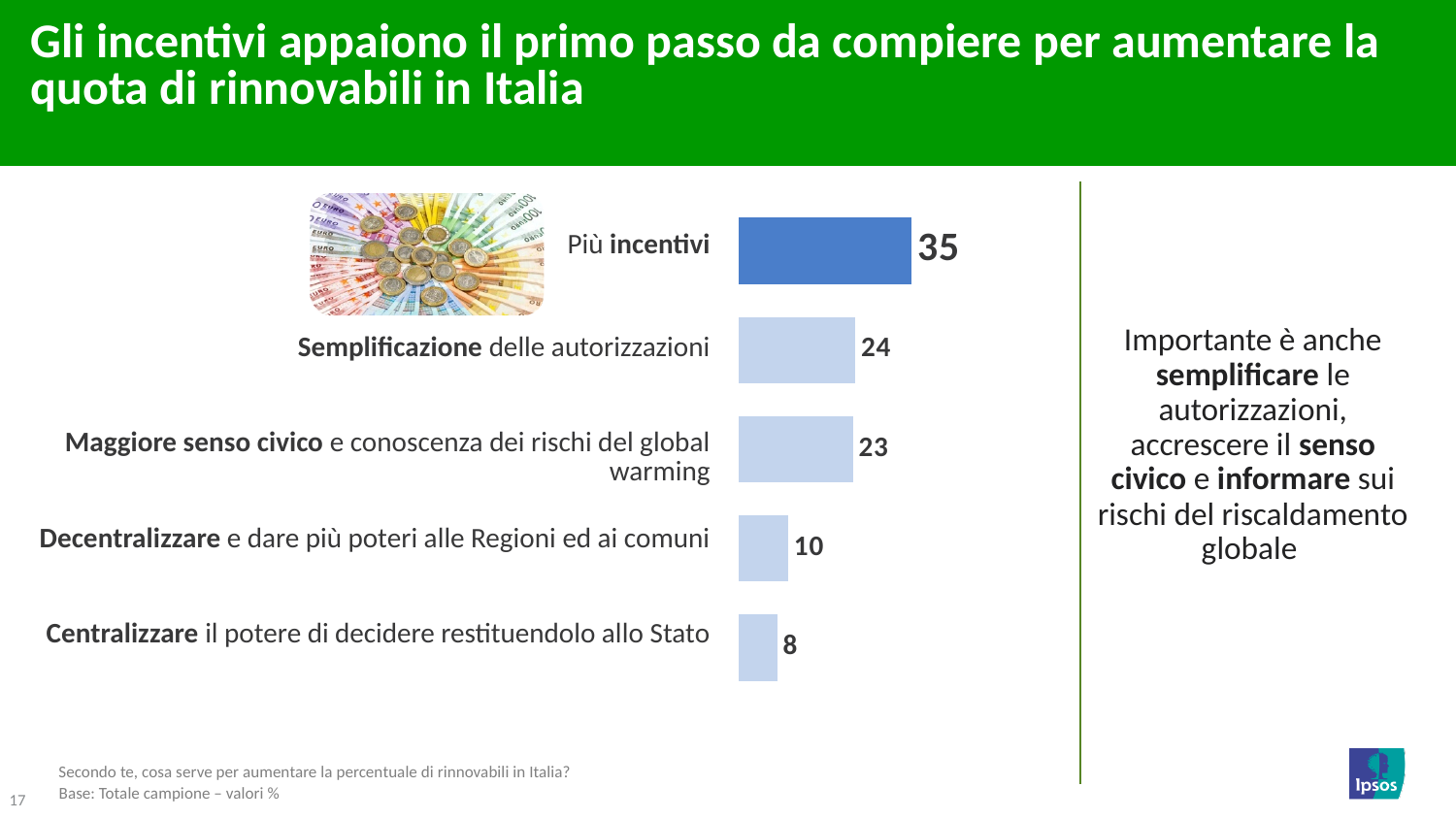
What is the value for "Centralizzare il potere di decidere restituendolo allo Stato"? 8 What is the difference between the values for "Più incentivi" and "Semplificazione delle autorizzazioni"? 11 What is the value for "Decentralizzare e dare più poteri alle Regioni ed ai comuni"? 10 Which category has the highest value? Più incentivi What is the difference between the values for "Decentralizzare e dare più poteri alle Regioni ed ai comuni" and "Centralizzare il potere di decidere restituendolo allo Stato"? 2 Which bar is shown in a darker blue than the others? Più incentivi Which is larger: the value for "Semplificazione delle autorizzazioni" or the value for "Maggiore senso civico e conoscenza dei rischi del global warming"? Semplificazione delle autorizzazioni What is the value for "Semplificazione delle autorizzazioni"? 24 What kind of chart is shown on the slide? Bar chart Which category has the lowest value? Centralizzare il potere di decidere restituendolo allo Stato How many categories are shown in the chart? 5 What is the value for "Più incentivi"? 35